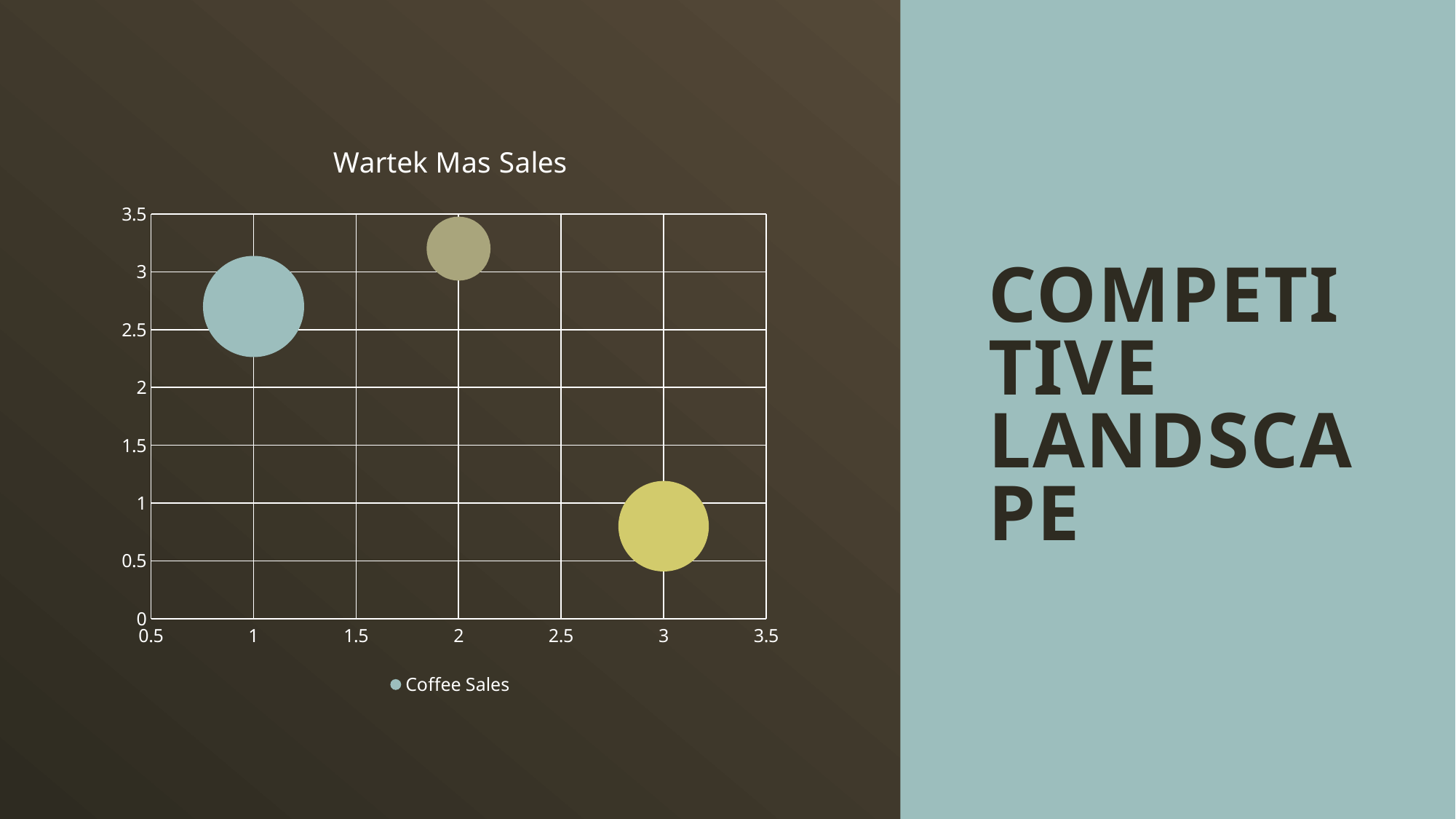
Is the y-axis value of the bubble at x = 1 greater or less than 2? greater What is the title of the chart? Wartek Mas Sales Is the y-axis value of the bubble at x = 3 greater or less than 1? less Which bubble has the lowest vertical (y-axis) position: the one at x = 1, x = 2, or x = 3? x = 3 How many series does the legend list? 1 What is the name of the series shown in the legend? Coffee Sales Which bubble is positioned higher on the y axis: the one at x = 1 or the one at x = 3? x = 1 Is the y-axis value of the bubble at x = 2 greater or less than 3? greater Which bubble has the highest vertical (y-axis) position: the one at x = 1, x = 2, or x = 3? x = 2 What is the highest value shown on the y axis? 3.5 How many bubbles are plotted on the chart? 3 What kind of chart is shown on the slide? Bubble chart